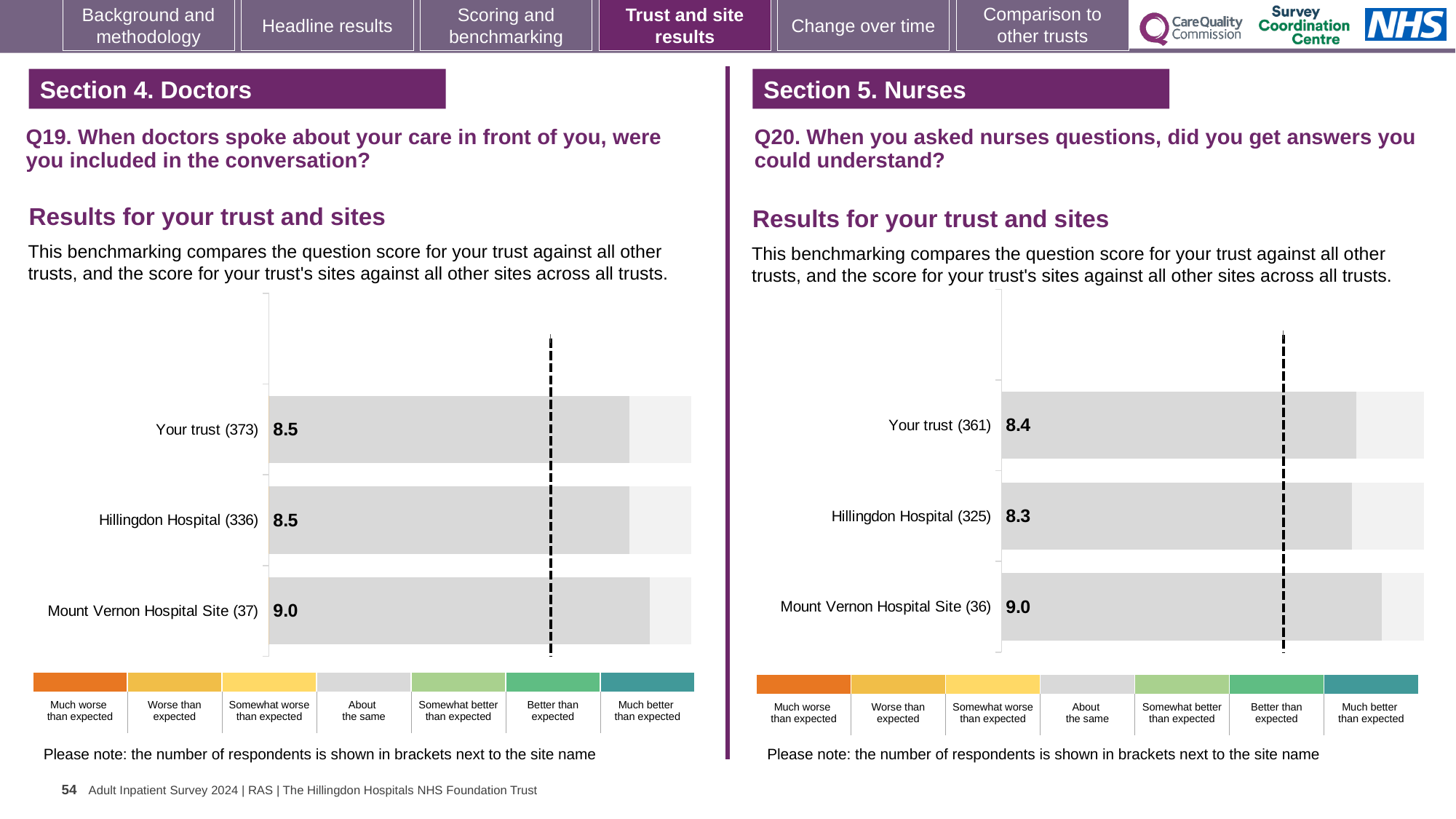
In the Q20 chart on the right, what is the difference between the Mount Vernon Hospital Site score and the Hillingdon Hospital score? 0.7 What type of chart is used in the Q20 chart on the right? Bar chart How many bars are plotted in the Q19 chart on the left? 3 In the Q19 chart on the left, what is the difference between the Mount Vernon Hospital Site score and the Your trust score? 0.5 How many respondents are shown in brackets for Mount Vernon Hospital Site in the Q20 chart on the right? 36 In the Q20 chart on the right, what is the score for Your trust? 8.4 In the Q20 chart on the right, which site or trust has the lowest score? Hillingdon Hospital In the Q19 chart on the left, what is the score for Mount Vernon Hospital Site? 9.0 In the Q20 chart on the right, what is the score for Hillingdon Hospital? 8.3 In the Q19 chart on the left, which site or trust has the highest score? Mount Vernon Hospital Site In the Q20 chart on the right, which has the higher score, Your trust or Hillingdon Hospital? Your trust In the Q19 chart on the left, what is the score for Your trust? 8.5